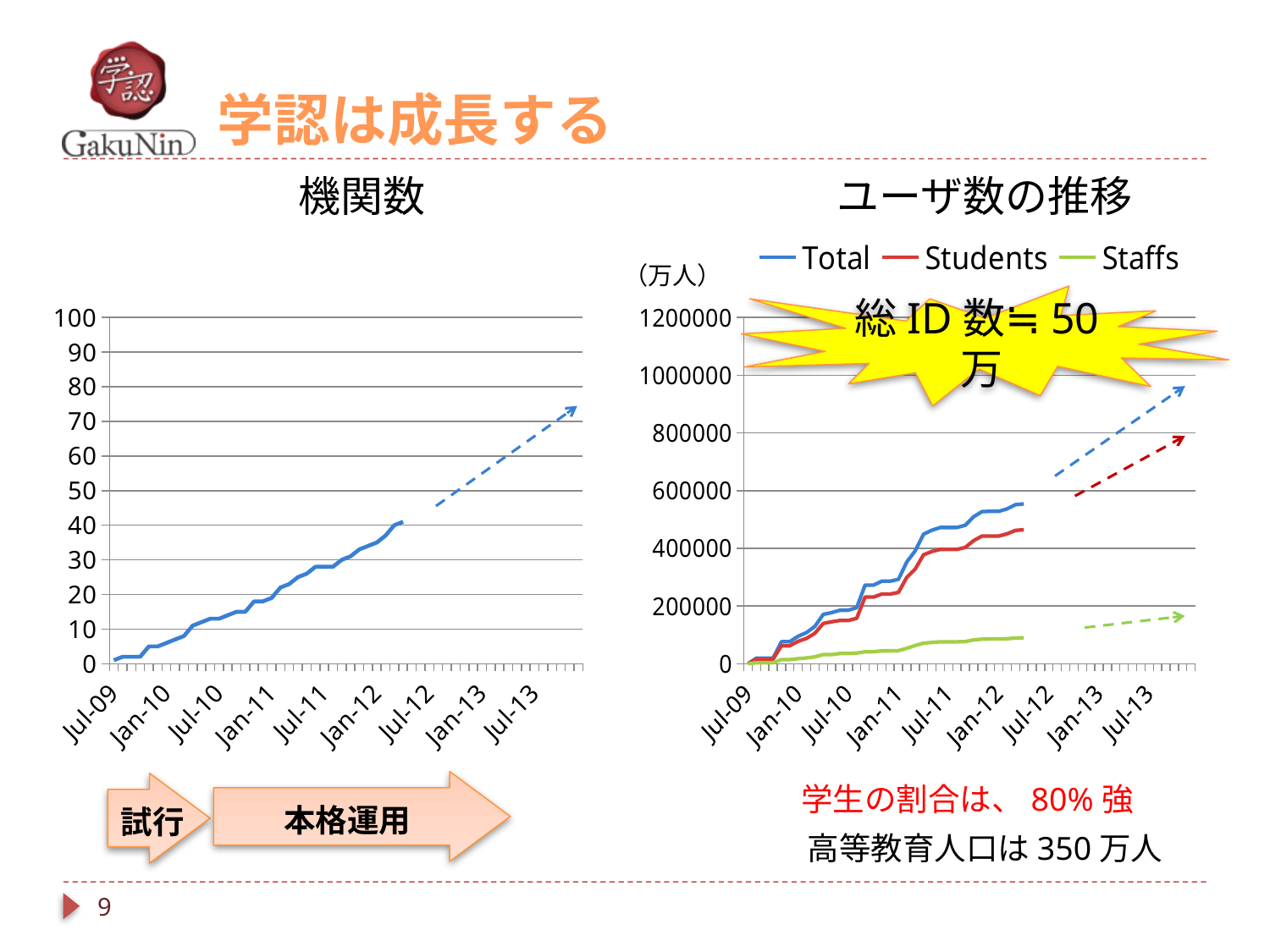
In the right chart (ユーザ数の推移), is the Total value at Jan-12 greater or less than 400000? greater What kind of chart is the left chart titled 機関数? line chart In the right chart (ユーザ数の推移), is the Staffs value at Jan-12 greater or less than 200000? less What are the series names in the legend of the right chart (ユーザ数の推移)? Total, Students, Staffs In the left chart (機関数), is the value at Jul-09 greater or less than 10? less In the right chart (ユーザ数の推移), which series has the lowest values throughout? Staffs In the right chart (ユーザ数の推移), which series has the highest values throughout? Total What kind of chart is the right chart titled ユーザ数の推移? line chart In the left chart (機関数), do the values rise or fall from Jul-09 to Jul-12? rise In the right chart (ユーザ数の推移), which is larger at Jan-12, Students or Staffs? Students How many series does the legend of the right chart (ユーザ数の推移) list? 3